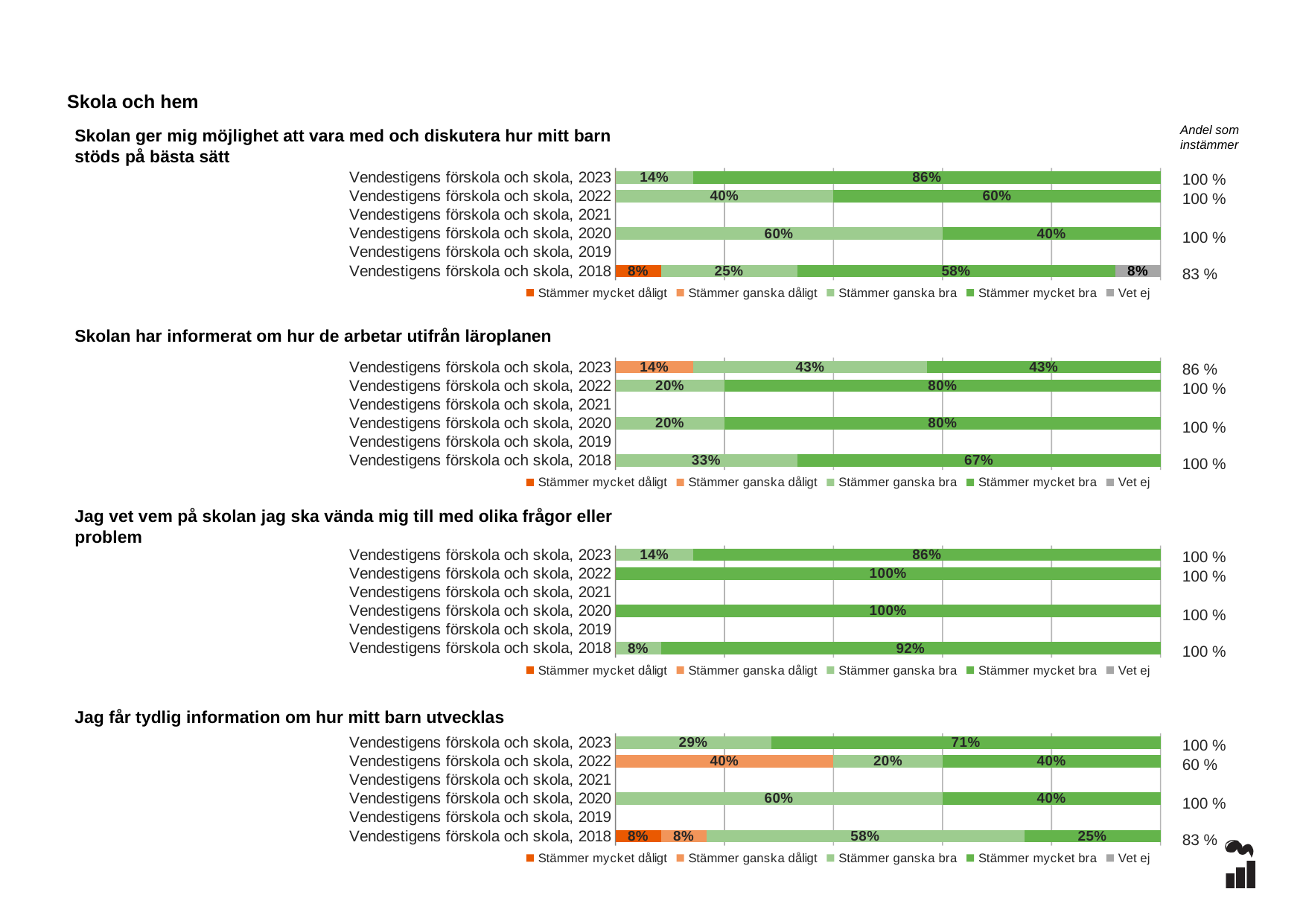
In the chart 'Skolan har informerat om hur de arbetar utifrån läroplanen', what is the 'Andel som instämmer' value for Vendestigens förskola och skola, 2023? 86 % In the chart 'Skolan har informerat om hur de arbetar utifrån läroplanen', what is the 'Stämmer ganska dåligt' value for Vendestigens förskola och skola, 2023? 14% In the chart 'Skolan ger mig möjlighet att vara med och diskutera hur mitt barn stöds på bästa sätt', what is the 'Stämmer mycket bra' value for Vendestigens förskola och skola, 2023? 86% In the chart 'Jag vet vem på skolan jag ska vända mig till med olika frågor eller problem', which year has the lowest 'Stämmer mycket bra' value? 2023 In the chart 'Jag vet vem på skolan jag ska vända mig till med olika frågor eller problem', what is the 'Stämmer mycket bra' value for Vendestigens förskola och skola, 2022? 100% What kind of chart is 'Jag får tydlig information om hur mitt barn utvecklas'? Stacked bar chart In the chart 'Jag får tydlig information om hur mitt barn utvecklas', what is the 'Stämmer ganska dåligt' value for Vendestigens förskola och skola, 2022? 40% In the chart 'Jag får tydlig information om hur mitt barn utvecklas', what is the difference between the 'Stämmer mycket bra' values for 2023 and 2018? 46% In the chart 'Jag får tydlig information om hur mitt barn utvecklas', what is the 'Andel som instämmer' value for Vendestigens förskola och skola, 2022? 60 % In the chart 'Skolan har informerat om hur de arbetar utifrån läroplanen', which is larger: the 'Stämmer mycket bra' value for 2022 or for 2018? 2022 How many series does the legend list in the chart 'Skolan ger mig möjlighet att vara med och diskutera hur mitt barn stöds på bästa sätt'? 5 In the chart 'Skolan ger mig möjlighet att vara med och diskutera hur mitt barn stöds på bästa sätt', what is the 'Vet ej' value for Vendestigens förskola och skola, 2018? 8%